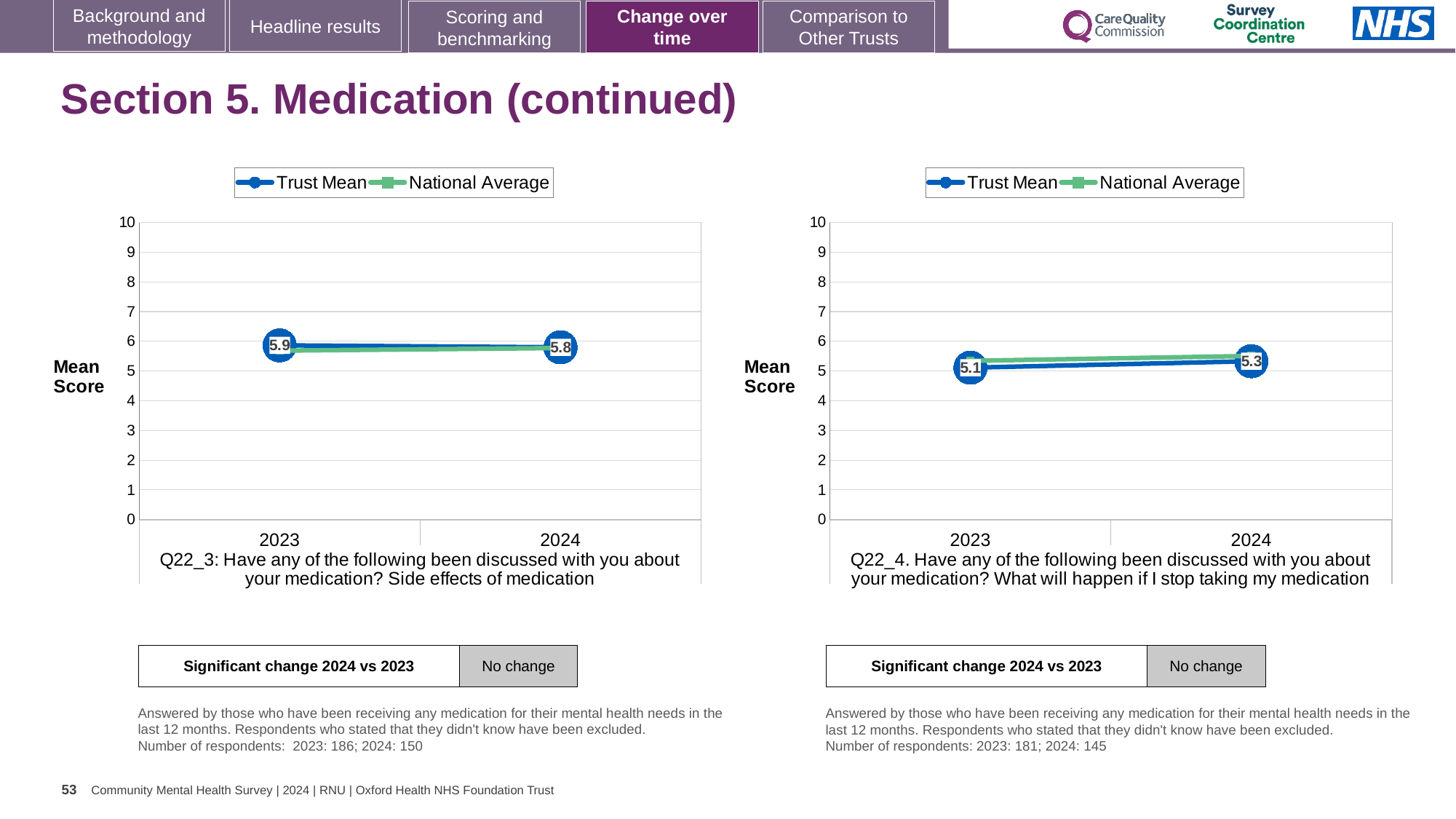
On the right chart (Q22_4), does the Trust Mean rise or fall from 2023 to 2024? rise How many years are plotted on the x axis of the right chart (Q22_4)? 2 On the left chart (Q22_3), what is the Trust Mean for 2024? 5.8 On the left chart (Q22_3), does the Trust Mean rise or fall from 2023 to 2024? fall What kind of chart is the left chart (Q22_3)? line chart On the left chart (Q22_3), which year has the higher Trust Mean, 2023 or 2024? 2023 On the right chart (Q22_4), by how much did the Trust Mean change from 2023 to 2024? 0.2 How many series does the legend of the left chart (Q22_3) list? 2 On the right chart (Q22_4), what is the Trust Mean for 2024? 5.3 On the right chart (Q22_4), what is the Trust Mean for 2023? 5.1 On the left chart (Q22_3), what is the Trust Mean for 2023? 5.9 On the right chart (Q22_4), is the National Average for 2023 greater or less than 6? less